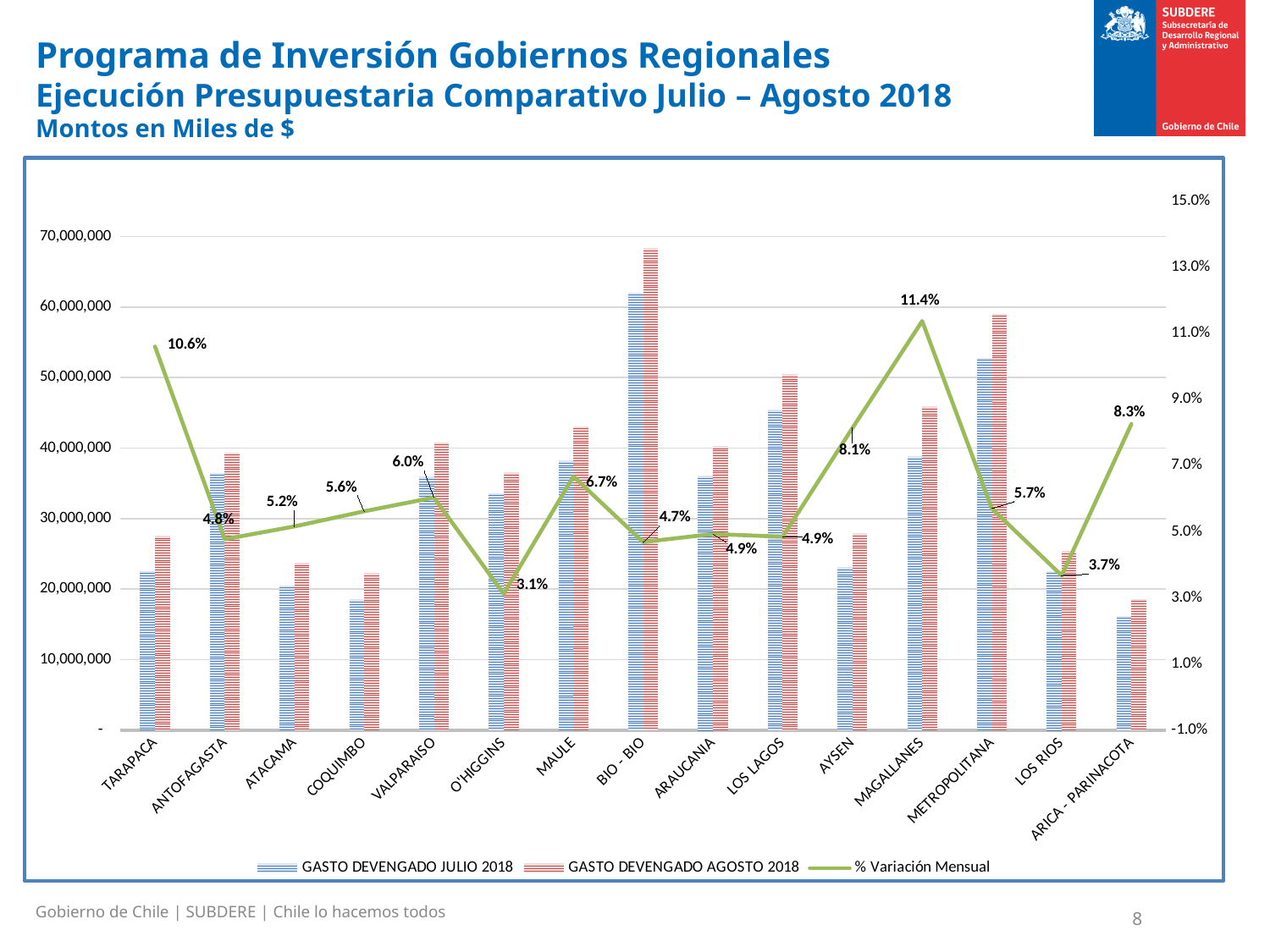
Is the GASTO DEVENGADO AGOSTO 2018 value for BIO - BIO greater or less than 60,000,000? greater How many series does the legend list? 3 Which region has the lowest % Variación Mensual? O'HIGGINS What is the % Variación Mensual value for TARAPACA? 10.6% What is the % Variación Mensual value for MAGALLANES? 11.4% What is the % Variación Mensual value for O'HIGGINS? 3.1% Which region has the tallest GASTO DEVENGADO AGOSTO 2018 bar? BIO - BIO Is the GASTO DEVENGADO JULIO 2018 value for ARICA - PARINACOTA greater or less than 20,000,000? less Which region has the highest % Variación Mensual? MAGALLANES How many regions are shown on the x axis of the chart? 15 Which region has the larger % Variación Mensual, TARAPACA or AYSEN? TARAPACA What is the difference in percentage points between the % Variación Mensual of MAGALLANES and O'HIGGINS? 8.3 percentage points